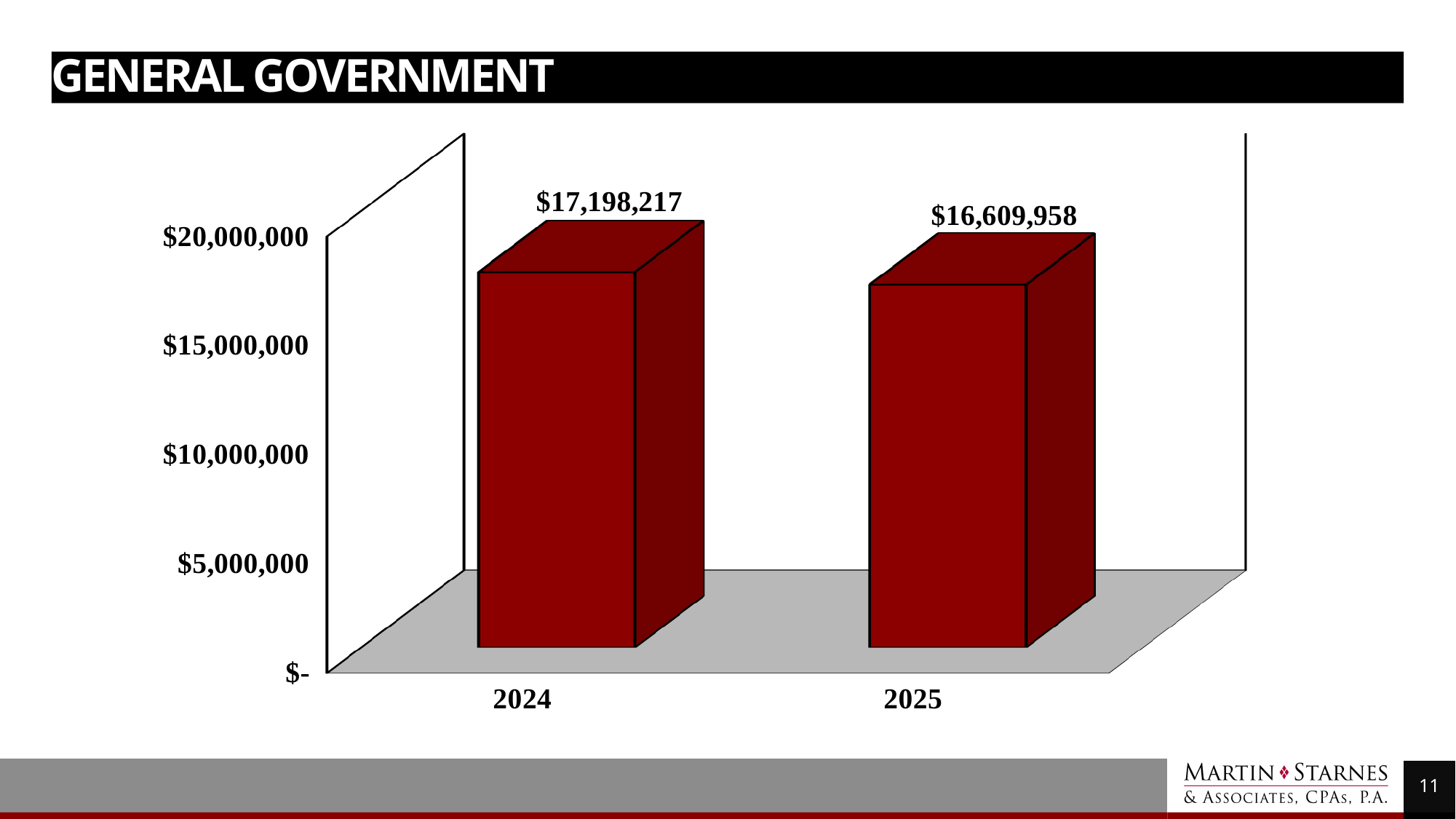
What is the value for 2024? $17,198,217 Is the value for 2024 greater or less than $20,000,000? less Which year has the lower value? 2025 Is the value for 2024 larger or smaller than the value for 2025? larger What is the title of the slide containing the chart? GENERAL GOVERNMENT How many bars are shown in the chart? 2 What kind of chart is shown on the slide? bar chart Do the values rise or fall from 2024 to 2025? fall Which year has the higher value? 2024 What is the value for 2025? $16,609,958 Is the value for 2025 greater or less than $15,000,000? greater What is the difference between the 2024 and 2025 values? $588,259